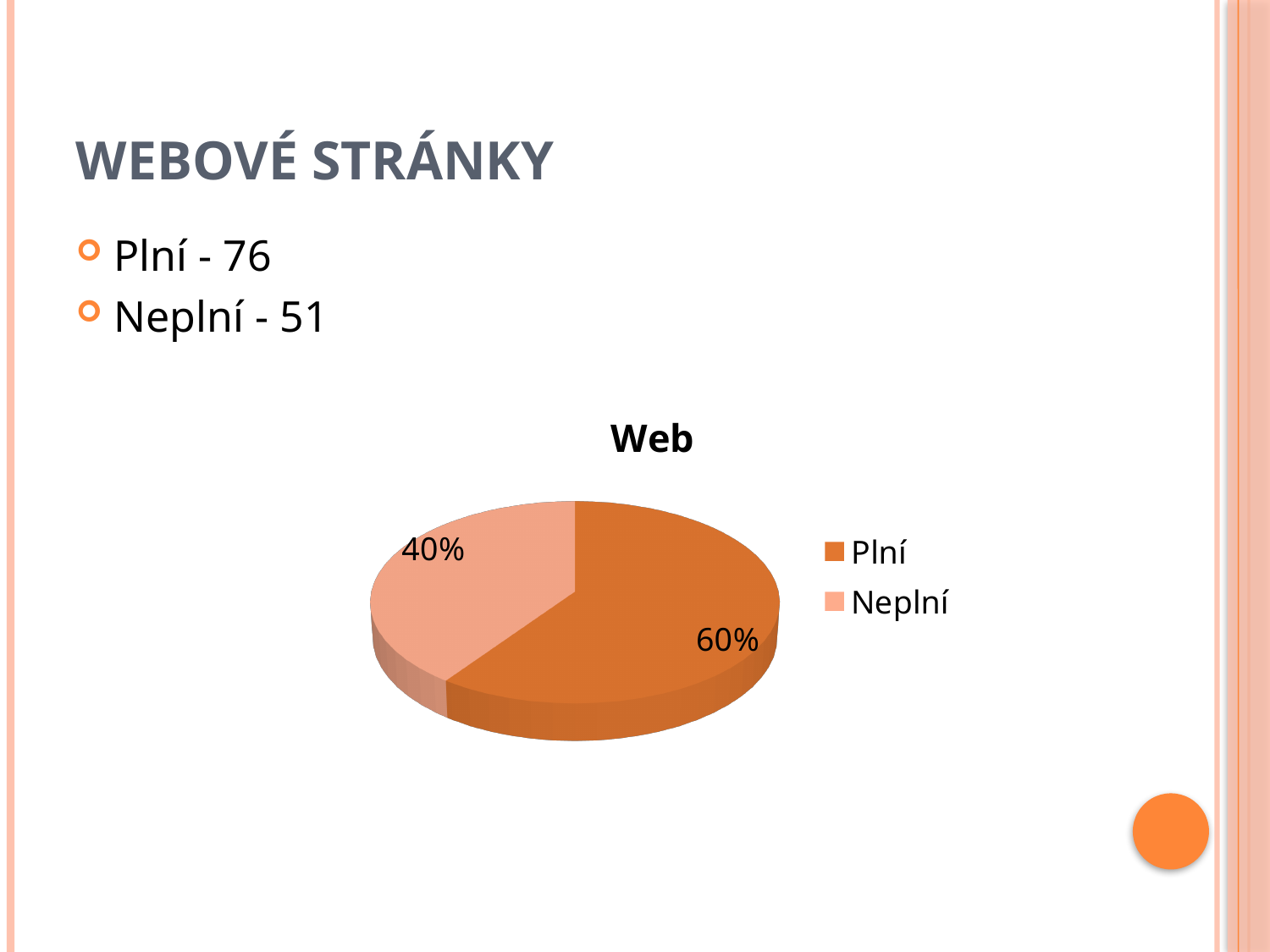
What is the title of the chart? Web How many slices does the pie chart have? 2 What kind of chart is shown on the slide? pie chart What share of the pie does the Neplní slice represent? 40% Which slice is the smallest in the pie chart? Neplní What is the difference in percentage points between the Plní and Neplní slices? 20% Which legend entry is shown in the lighter orange colour? Neplní Is the share for Neplní greater or less than 50%? less What share of the pie does the Plní slice represent? 60% How many entries does the legend list? 2 Which slice is the largest in the pie chart? Plní Which is larger, the Plní slice or the Neplní slice? Plní